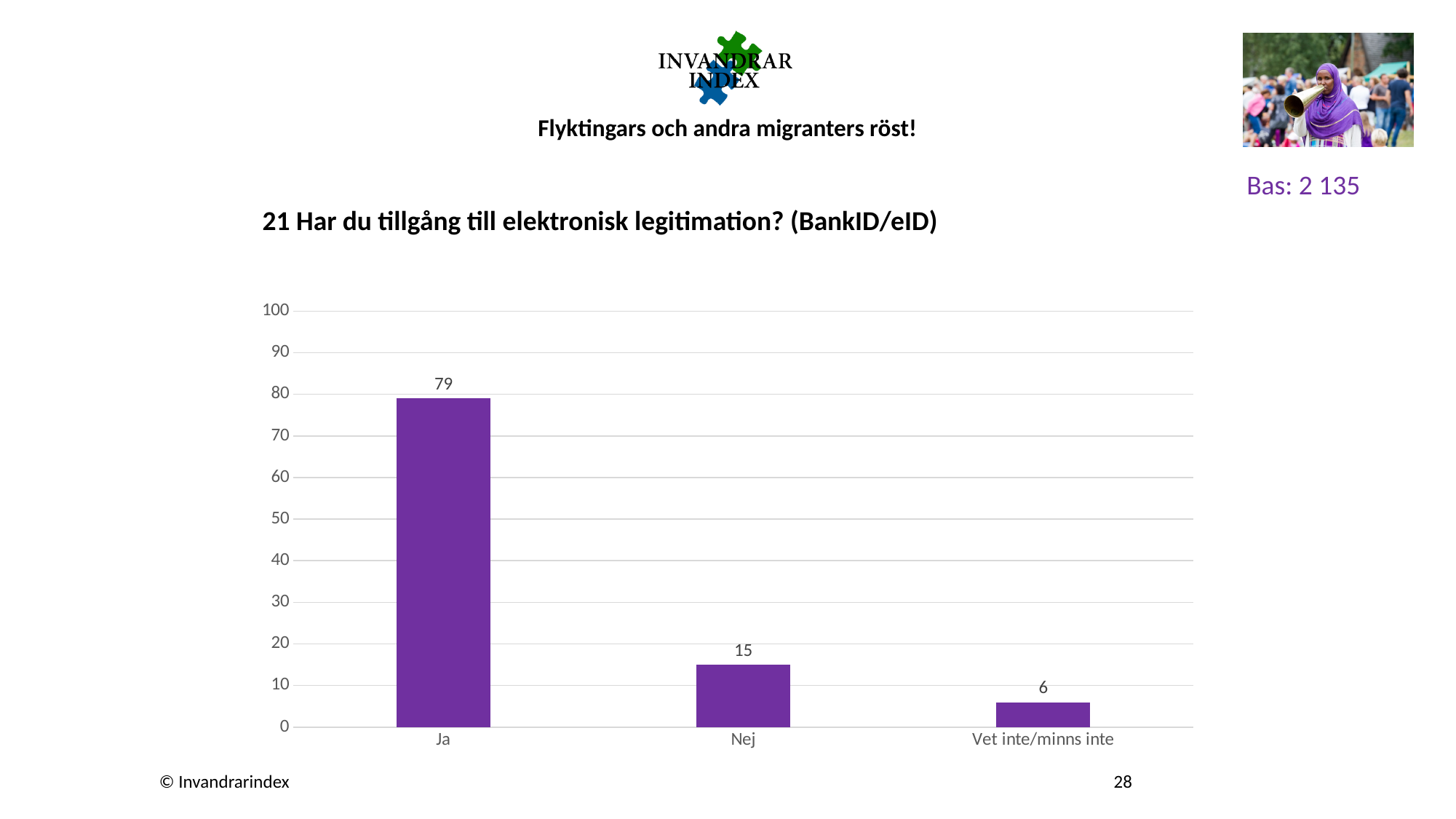
What is the value for "Vet inte/minns inte"? 6 What is the difference between the values for "Nej" and "Vet inte/minns inte"? 9 Which category has the highest value? Ja What is the difference between the values for "Ja" and "Nej"? 64 What is the value for "Nej"? 15 Is the value for "Ja" greater or less than 70? greater Which category has the lowest value? Vet inte/minns inte How many categories are shown on the x axis? 3 What kind of chart is shown on the slide? bar chart What is the title of the chart? 21 Har du tillgång till elektronisk legitimation? (BankID/eID) What is the value for "Ja"? 79 Which is larger, the value for "Nej" or the value for "Vet inte/minns inte"? Nej